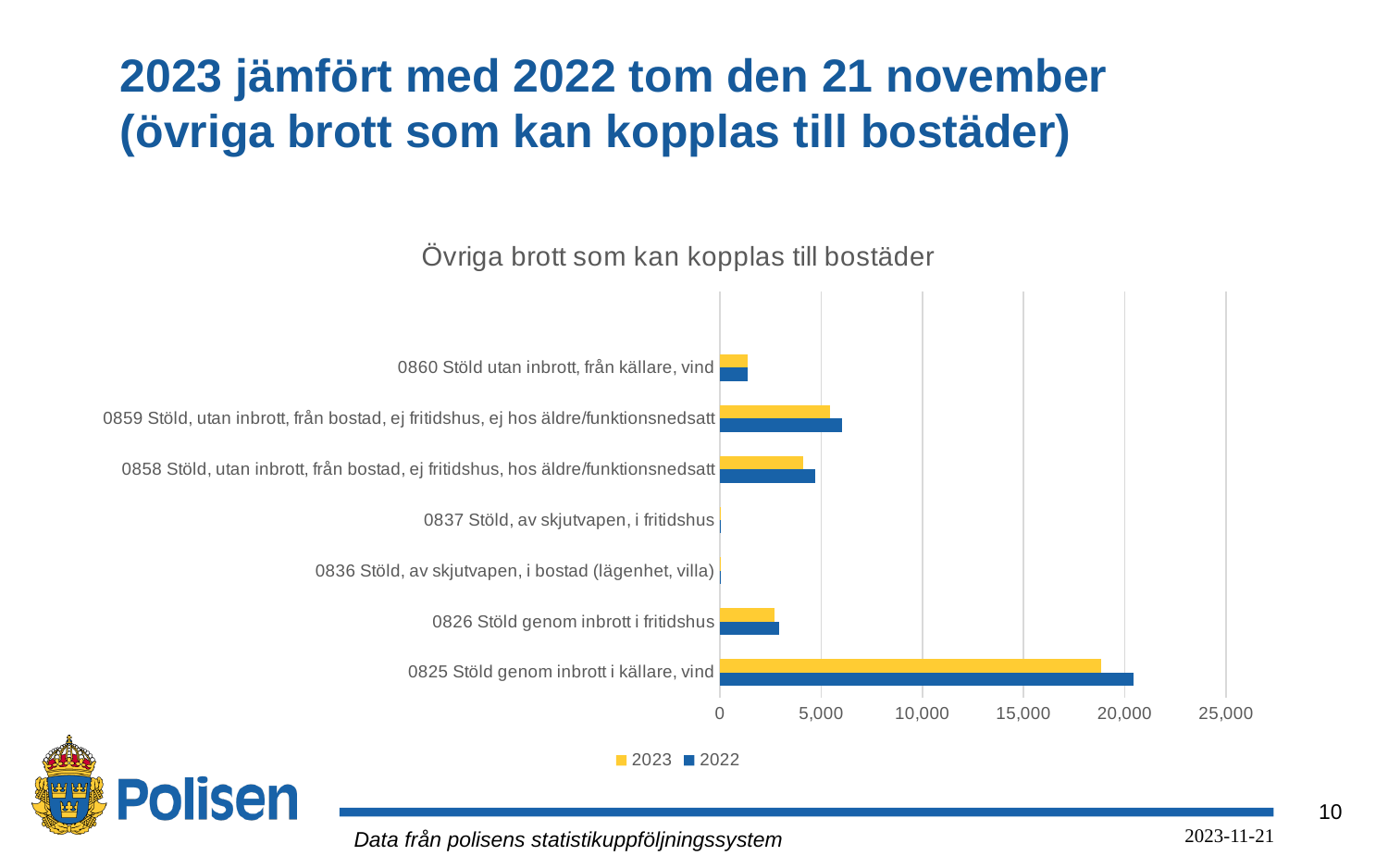
What is the title of the chart? Övriga brott som kan kopplas till bostäder Which category has the highest value for 2023? 0825 Stöld genom inbrott i källare, vind What type of chart is shown on the slide? bar chart Is the 2022 value for 0825 Stöld genom inbrott i källare, vind greater or less than 20,000? greater Which category has the highest value for 2022? 0825 Stöld genom inbrott i källare, vind For 0825 Stöld genom inbrott i källare, vind, which year has the larger value, 2023 or 2022? 2022 Is the 2022 value for 0859 Stöld, utan inbrott, från bostad, ej fritidshus, ej hos äldre/funktionsnedsatt greater or less than 5,000? greater Is the 2023 value for 0825 Stöld genom inbrott i källare, vind greater or less than 20,000? less For 2023, which category has the larger value: 0859 Stöld, utan inbrott, från bostad, ej fritidshus, ej hos äldre/funktionsnedsatt or 0858 Stöld, utan inbrott, från bostad, ej fritidshus, hos äldre/funktionsnedsatt? 0859 Stöld, utan inbrott, från bostad, ej fritidshus, ej hos äldre/funktionsnedsatt How many series does the legend list? 2 How many categories are shown on the chart? 7